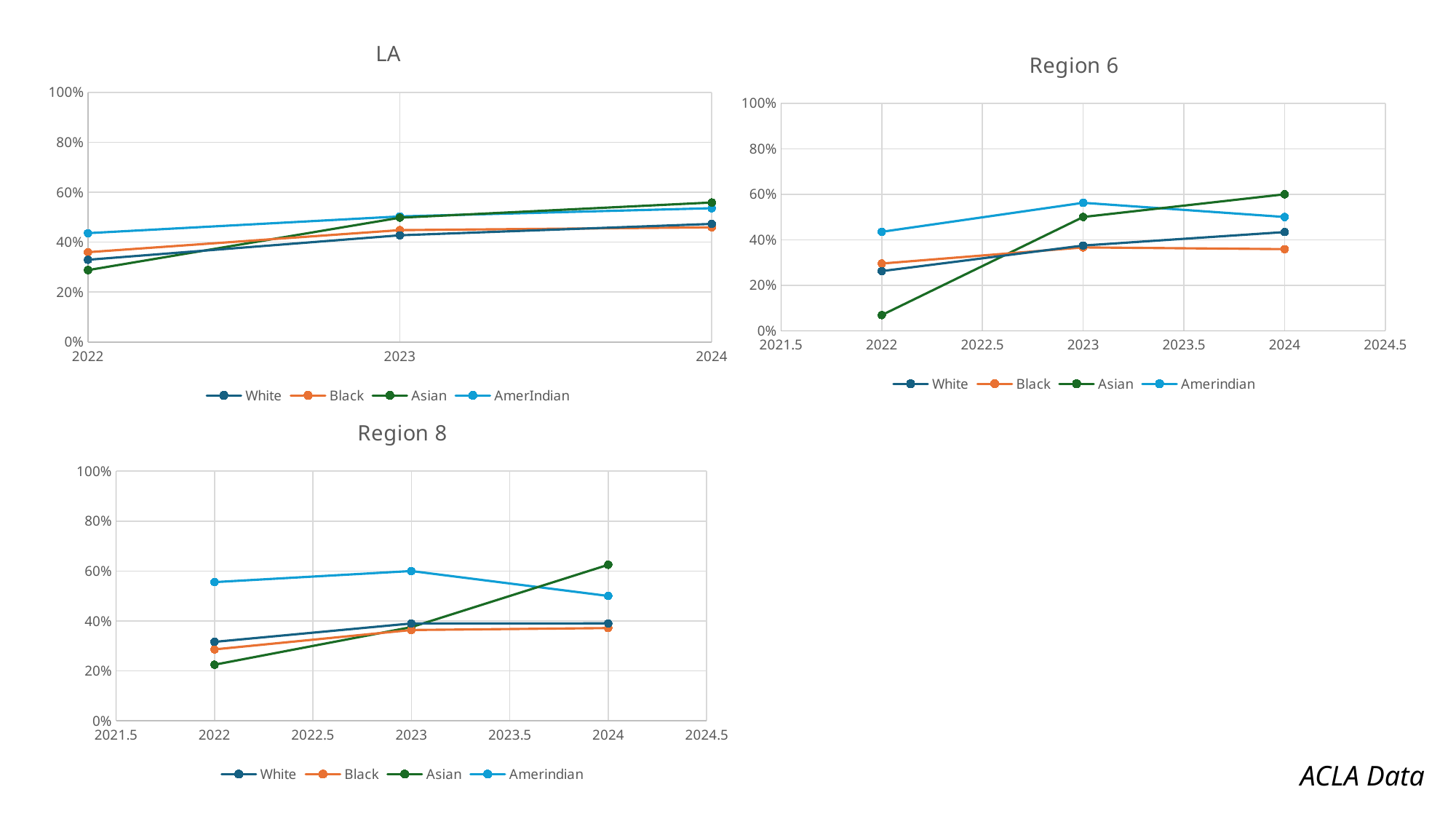
In the LA chart, is the value for Asian in 2022 greater or less than 40%? less In the Region 6 chart, which series has the highest value in 2024? Asian In the Region 8 chart, is the value for Asian in 2024 greater or less than 50%? greater In the LA chart, which series has the lowest value in 2022? Asian In the Region 6 chart, is the value for Asian in 2022 greater or less than 20%? less In the Region 6 chart, which is larger in 2022, White or Asian? White In the Region 8 chart, does the Asian series rise or fall from 2022 to 2024? rise How many series does the legend of the LA chart list? 4 In the Region 6 chart, which series has the lowest value in 2022? Asian What type of chart is the LA chart? line chart In the Region 8 chart, which series has the highest value in 2022? Amerindian